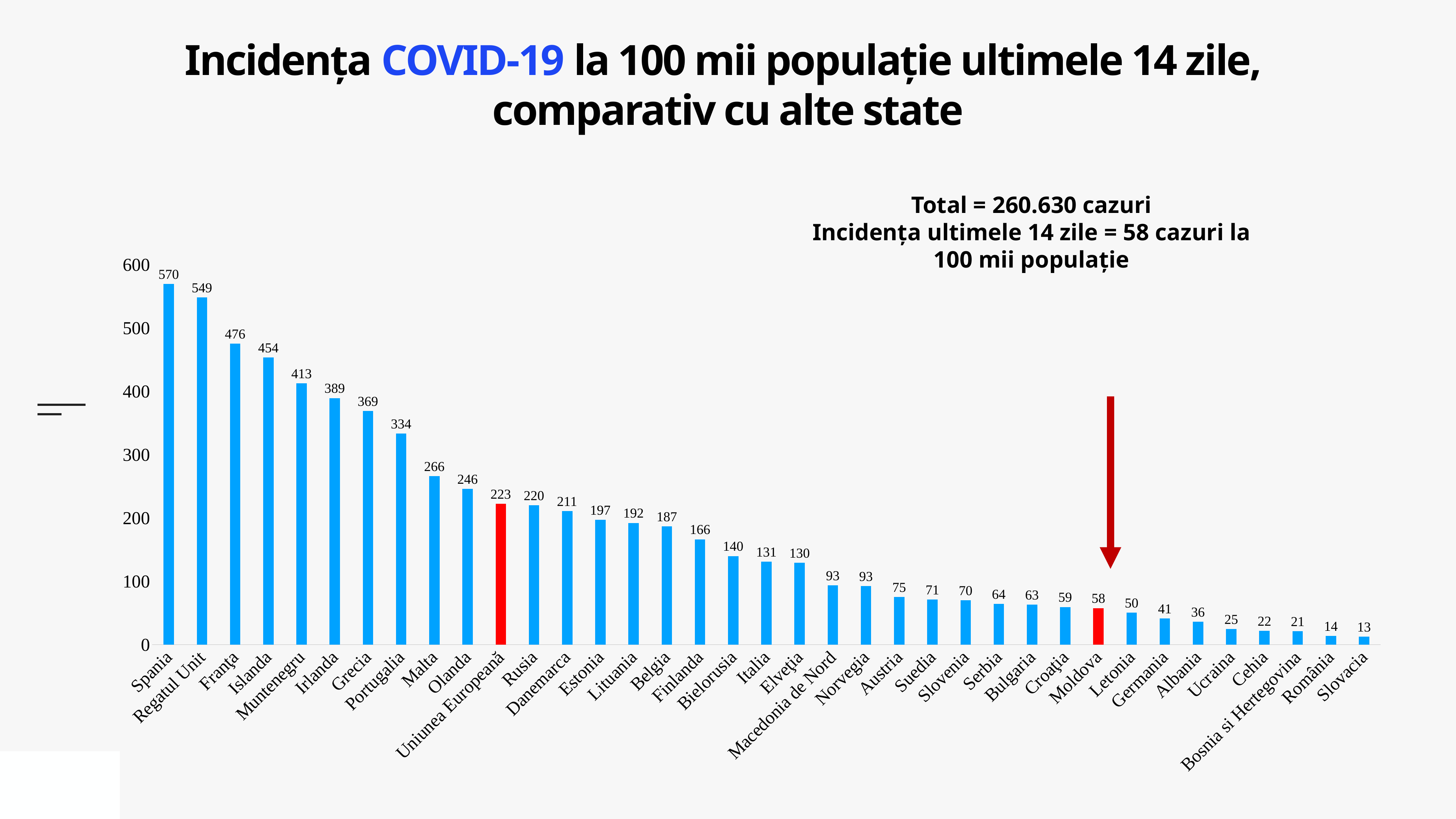
Which has a larger value, Italia or Austria? Italia What kind of chart is shown on the slide? bar chart Do the values rise or fall from left to right along the x axis? fall Is the value for Grecia greater or less than 300? greater What is the value for Uniunea Europeană? 223 What is the difference between the values for Spania and Regatul Unit? 21 What is the value for Moldova? 58 Which country has the highest value? Spania Which country has the lowest value? Slovacia What is the difference between the values for Uniunea Europeană and Moldova? 165 What is the value for Portugalia? 334 How many countries/regions are shown on the chart? 37